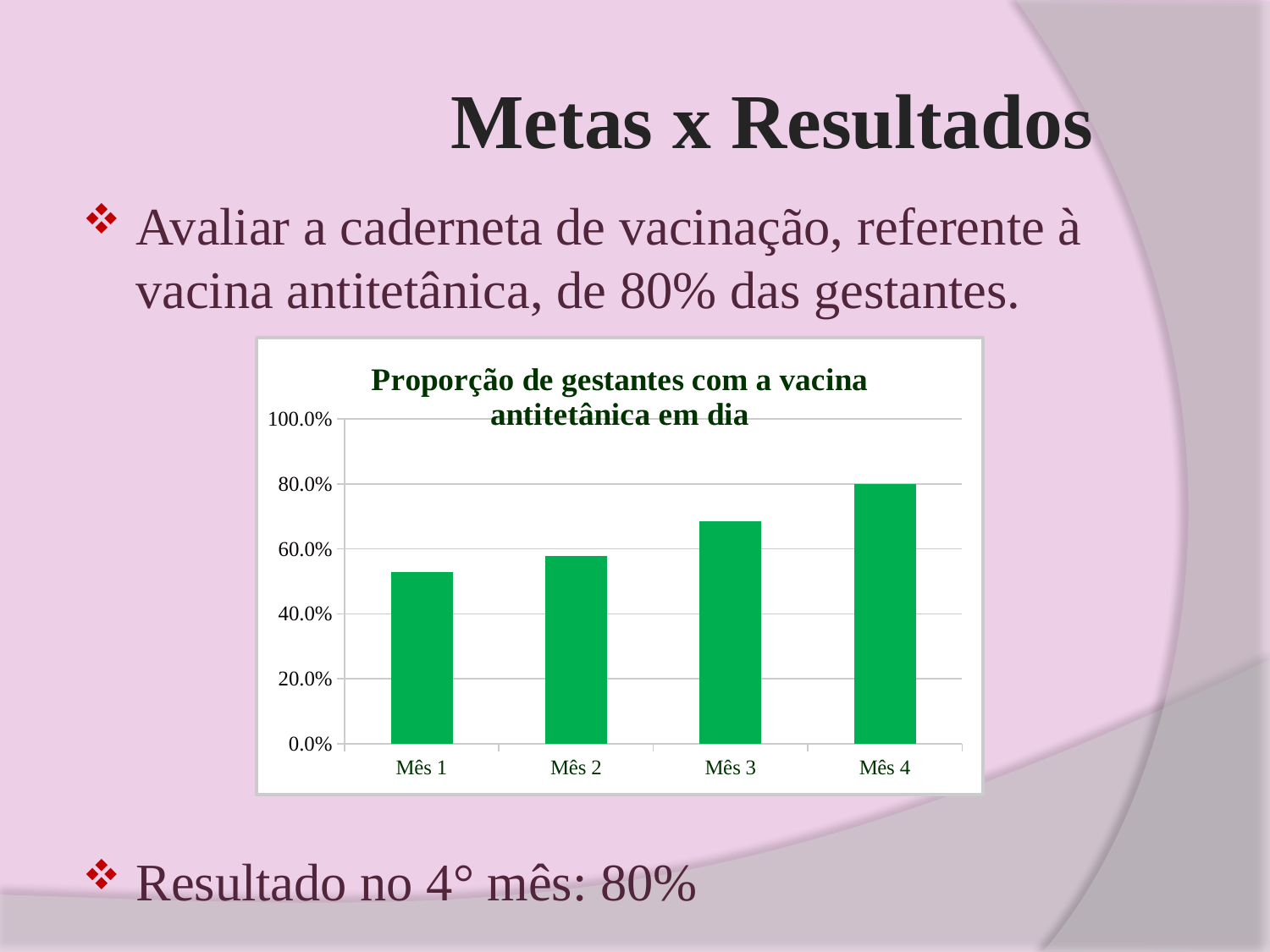
How many months (categories) are plotted on the chart? 4 Which month has the highest proportion of pregnant women with the tetanus vaccine up to date? Mês 4 Which is larger, the value for Mês 3 or the value for Mês 1? Mês 3 Is the value for Mês 1 greater or less than 60.0%? less Which month has the lowest proportion on the chart? Mês 1 What is the title of the chart? Proporção de gestantes com a vacina antitetânica em dia What kind of chart is shown on the slide? bar chart Is the value for Mês 2 greater or less than 40.0%? greater What colour are the bars in the chart? green Do the values rise or fall from Mês 1 to Mês 4? rise Is the value for Mês 3 greater or less than 60.0%? greater What is the value for Mês 4 on the chart? 80.0%